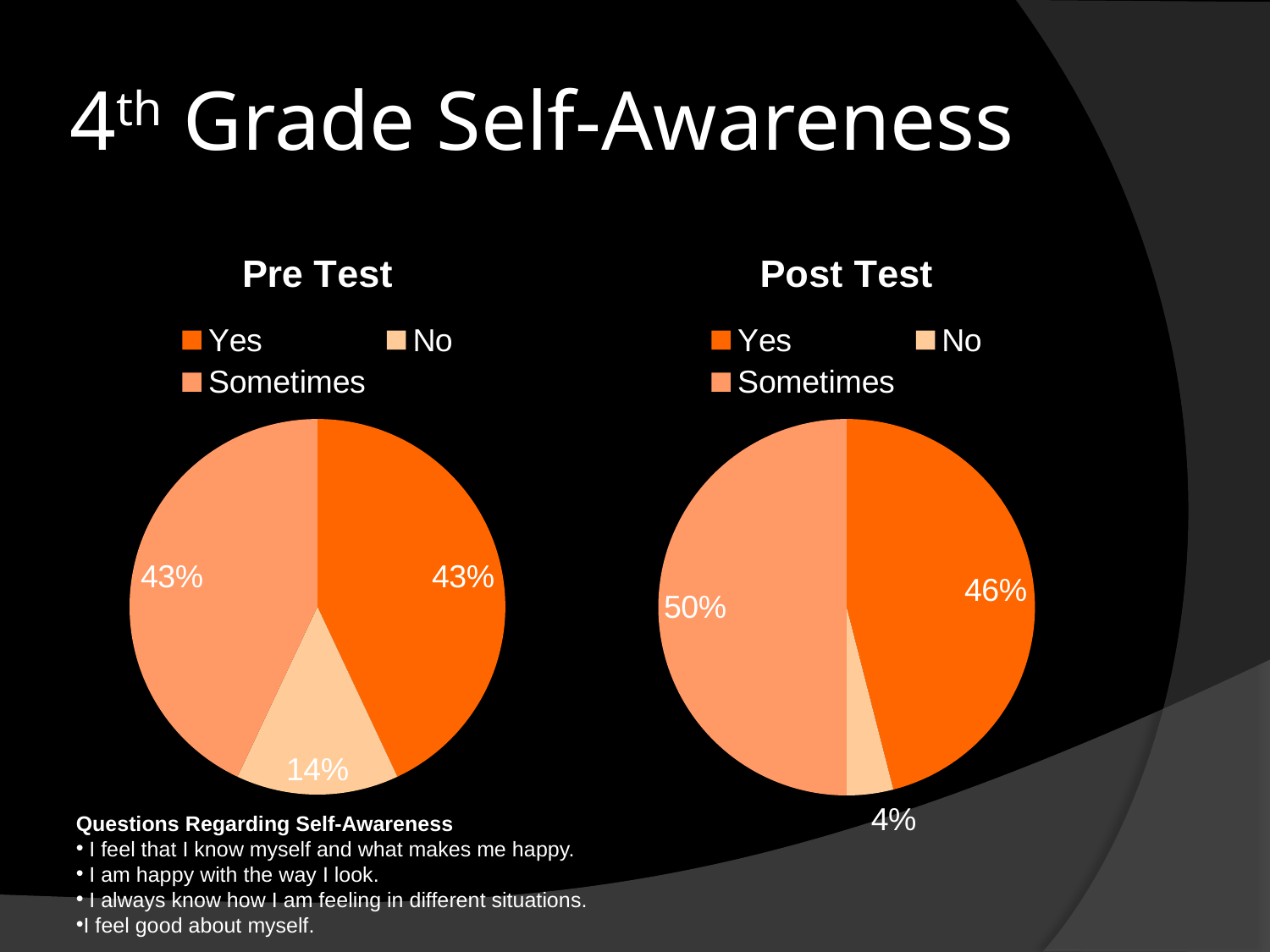
In the Pre Test chart, what percentage of responses were "No"? 14% In the Post Test chart, which category has the smallest share? No How many categories does the legend of the Post Test chart list? 3 What type of chart is the Pre Test chart? Pie chart In the Post Test chart, what percentage of responses were "Sometimes"? 50% In the Pre Test chart, what percentage of responses were "Yes"? 43% In the Post Test chart, which category has the largest share? Sometimes In the Pre Test chart, which two categories have the same share? Yes and Sometimes What is the difference between the "No" share in the Pre Test chart and the "No" share in the Post Test chart? 10% In the Post Test chart, what percentage of responses were "Yes"? 46% In the Pre Test chart, which category has the smallest share? No Is the "Yes" share larger in the Pre Test chart or the Post Test chart? Post Test